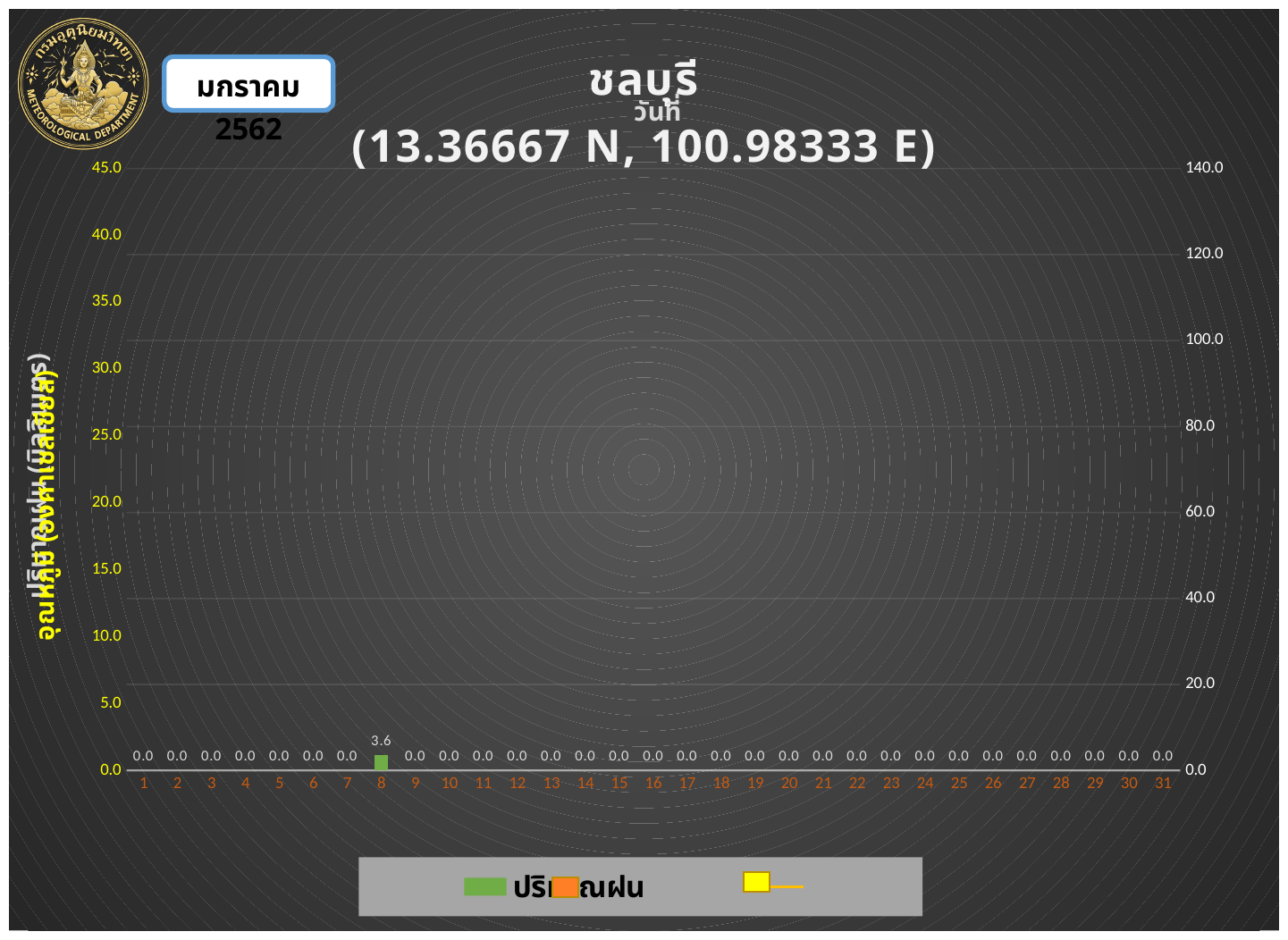
What is the difference between the rainfall value on day 8 and the value on day 9? 3.6 Is the rainfall value for day 8 greater or less than 5.0 on the left axis? less Which day has the highest rainfall value? 8 Which is larger, the rainfall value on day 8 or on day 15? day 8 What is the rainfall value shown for day 1? 0.0 What kind of chart is used to show the rainfall values? bar chart How many days are shown along the x axis? 31 What is the rainfall value shown for day 8? 3.6 What is the rainfall value shown for day 31? 0.0 What is the highest value labelled on the right vertical axis? 140.0 What is the highest value labelled on the left vertical axis? 45.0 How many days have a rainfall value of 0.0? 30